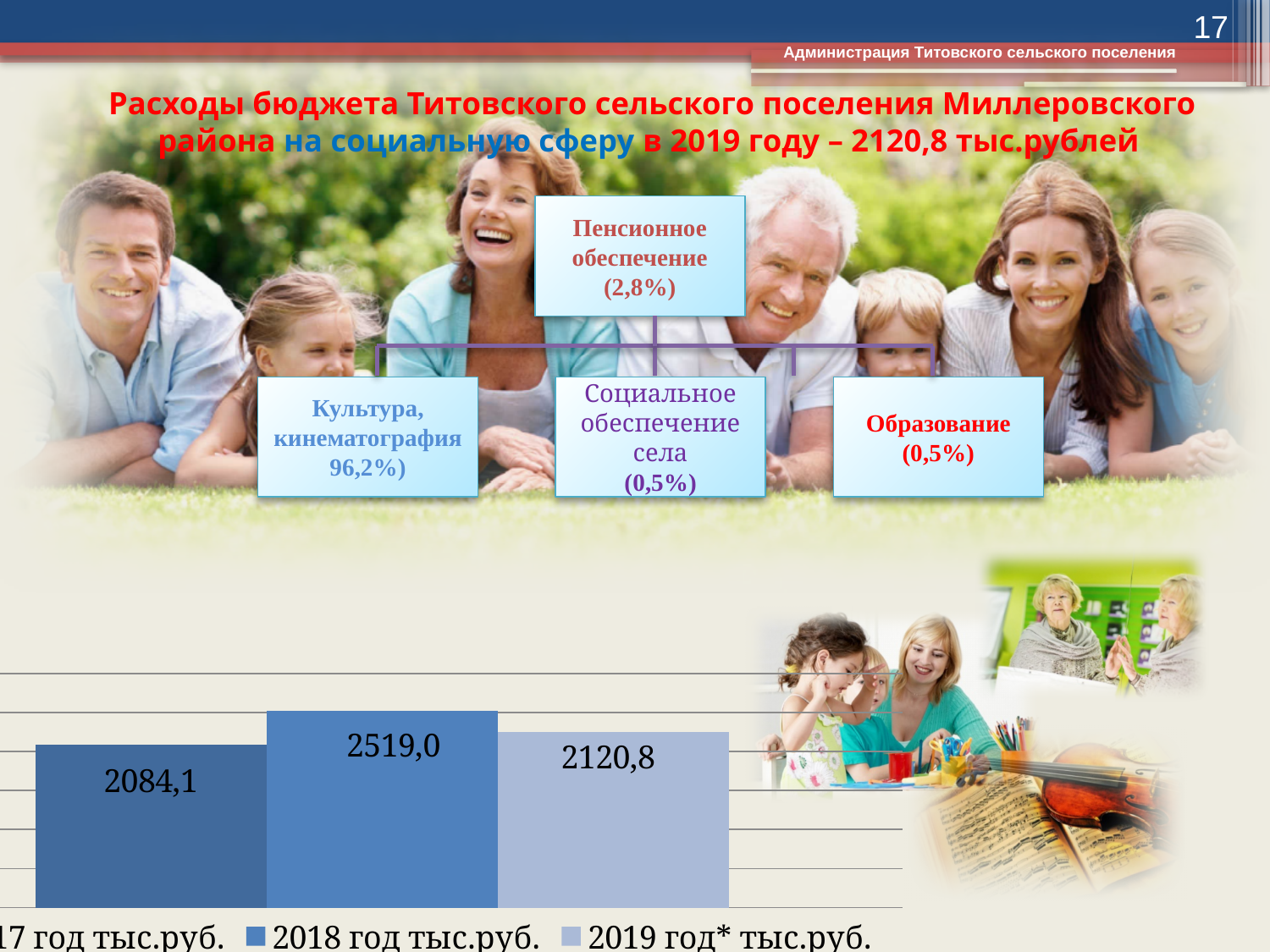
In the bar chart at the bottom of the slide, what is the difference between the 2018 value and the 2019 value? 398,2 In the bar chart at the bottom of the slide, by how much does the 2018 value exceed the leftmost bar's value of 2084,1? 434,9 In the bar chart at the bottom of the slide, what is the value of the bar for 2019 год* тыс.руб.? 2120,8 In the bar chart at the bottom of the slide, which bar has the lowest value? The leftmost bar (2084,1) In the bar chart at the bottom of the slide, what value is printed on the leftmost (dark blue) bar? 2084,1 How many bars are plotted in the bar chart at the bottom of the slide? 3 In the bar chart at the bottom of the slide, which year has the highest value? 2018 год тыс.руб. In the bar chart at the bottom of the slide, what is the value of the bar for 2018 год тыс.руб.? 2519,0 In the bar chart at the bottom of the slide, which is larger: the leftmost bar (2084,1) or the 2019 год* bar? 2019 год* тыс.руб. What type of chart is shown at the bottom of the slide? Bar chart In the bar chart at the bottom of the slide, which series is drawn in the lightest shade of blue? 2019 год* тыс.руб. How many series does the legend of the bar chart at the bottom of the slide list? 3